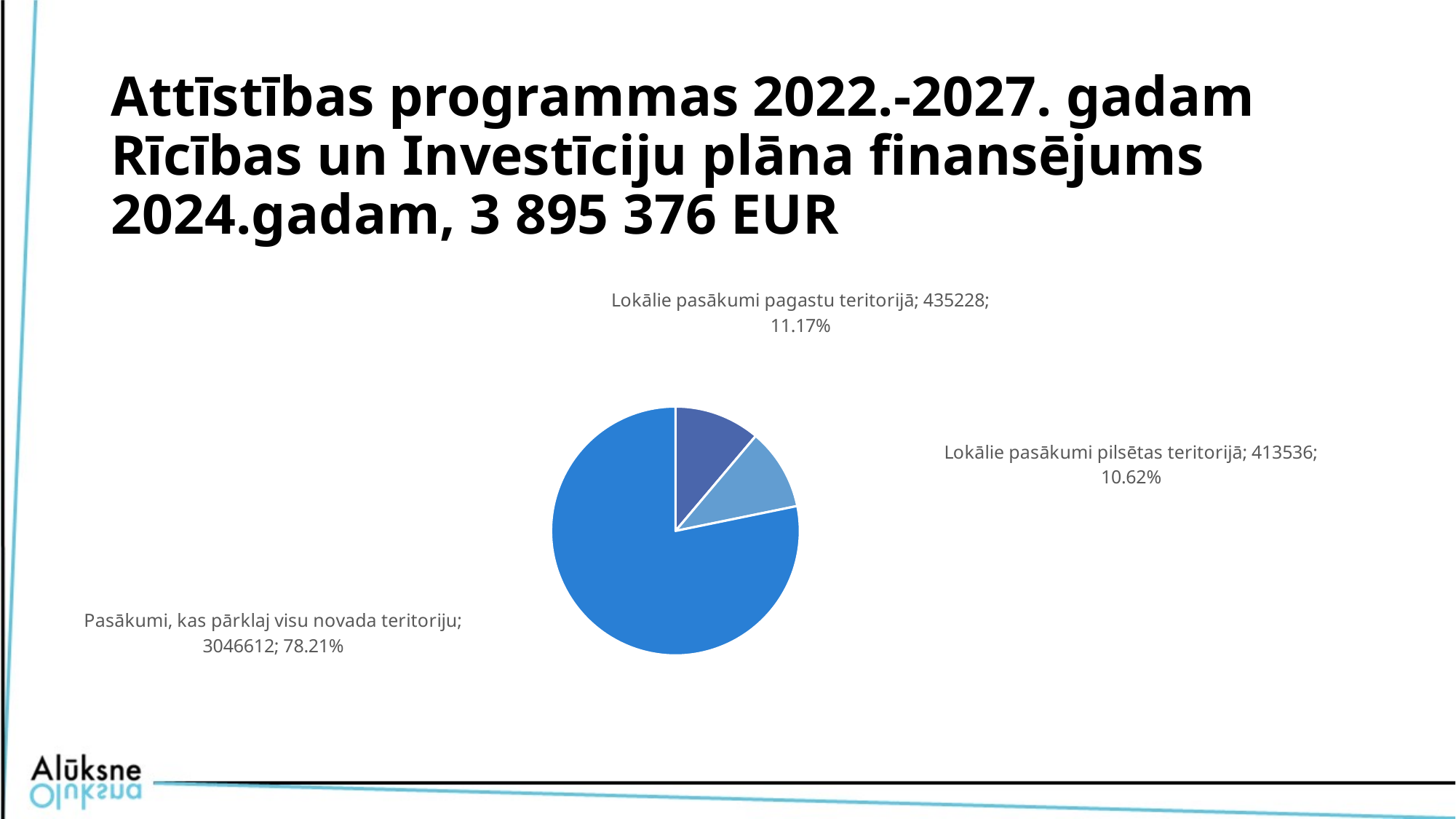
What share of the pie does "Lokālie pasākumi pagastu teritorijā" represent? 11.17% What share of the pie does "Lokālie pasākumi pilsētas teritorijā" represent? 10.62% What kind of chart is shown on the slide? pie chart What is the value for "Lokālie pasākumi pilsētas teritorijā"? 413536 Which category has the smallest slice of the pie? Lokālie pasākumi pilsētas teritorijā What is the difference between the values for "Lokālie pasākumi pagastu teritorijā" and "Lokālie pasākumi pilsētas teritorijā"? 21692 How many slices does the pie chart have? 3 What share of the pie does "Pasākumi, kas pārklaj visu novada teritoriju" represent? 78.21% What total funding amount for 2024 is stated in the slide title? 3 895 376 EUR What is the value for "Pasākumi, kas pārklaj visu novada teritoriju"? 3046612 What is the value for "Lokālie pasākumi pagastu teritorijā"? 435228 Which category has the largest slice of the pie? Pasākumi, kas pārklaj visu novada teritoriju